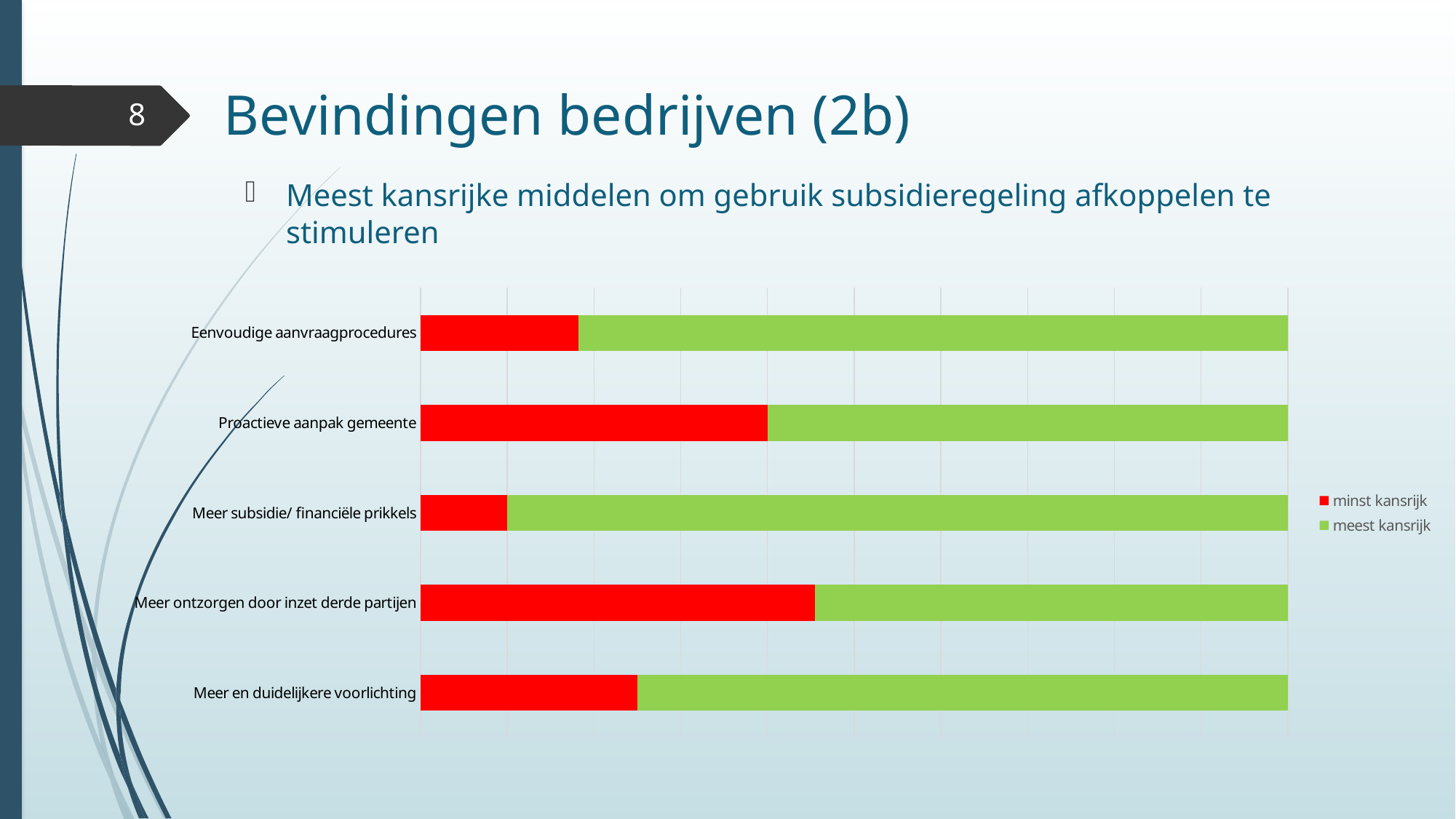
Which has the larger 'minst kansrijk' segment: Meer en duidelijkere voorlichting or Meer subsidie/ financiële prikkels? Meer en duidelijkere voorlichting What colour represents the 'minst kansrijk' series in the chart? Red What kind of chart is shown on the slide? Stacked bar chart Which has the larger 'meest kansrijk' segment: Meer en duidelijkere voorlichting or Proactieve aanpak gemeente? Meer en duidelijkere voorlichting Which category has the largest 'minst kansrijk' segment? Meer ontzorgen door inzet derde partijen Which has the larger 'minst kansrijk' segment: Proactieve aanpak gemeente or Eenvoudige aanvraagprocedures? Proactieve aanpak gemeente How many categories are plotted on the chart? 5 Which category has the smallest 'meest kansrijk' segment? Meer ontzorgen door inzet derde partijen What are the two entries listed in the chart's legend? minst kansrijk and meest kansrijk Which category has the smallest 'minst kansrijk' segment? Meer subsidie/ financiële prikkels How many series does the chart's legend list? 2 Which category has the largest 'meest kansrijk' segment? Meer subsidie/ financiële prikkels